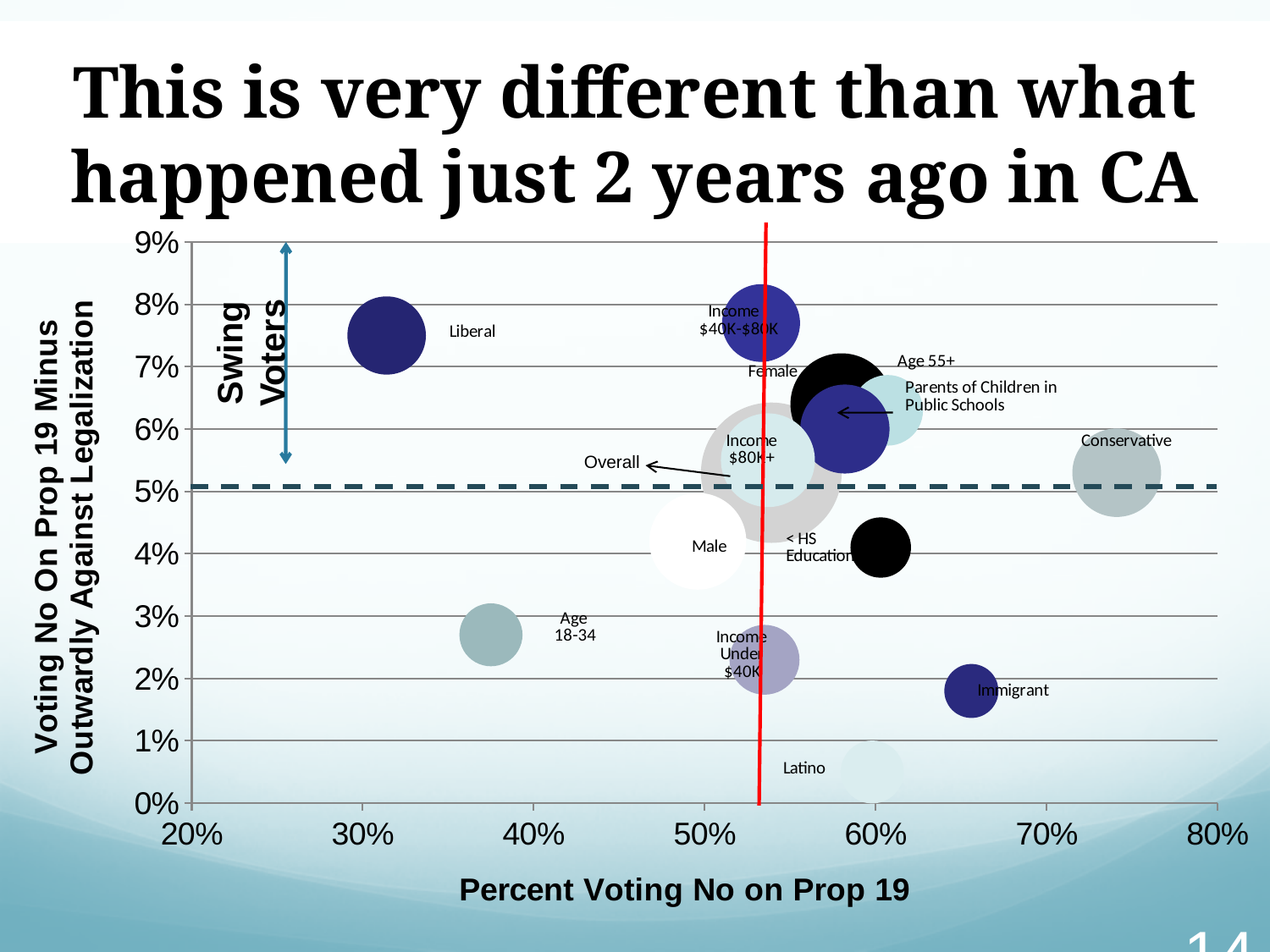
Which group has the lowest value on the x axis (Percent Voting No on Prop 19)? Liberal What is the title of the y axis of the chart? Voting No On Prop 19 Minus Outwardly Against Legalization Which group has the highest value on the x axis (Percent Voting No on Prop 19)? Conservative What is the title of the x axis of the chart? Percent Voting No on Prop 19 What kind of chart is shown on the slide? Bubble chart How many labeled bubbles are plotted on the chart? 14 Is the Percent Voting No on Prop 19 for Conservative greater or less than 70%? greater Which group has a higher Percent Voting No on Prop 19, Liberal or Conservative? Conservative Is the y-axis value for Latino greater or less than 1%? less Is the Percent Voting No on Prop 19 for Liberal greater or less than 40%? less Which group has the lowest value on the y axis (Voting No On Prop 19 Minus Outwardly Against Legalization)? Latino